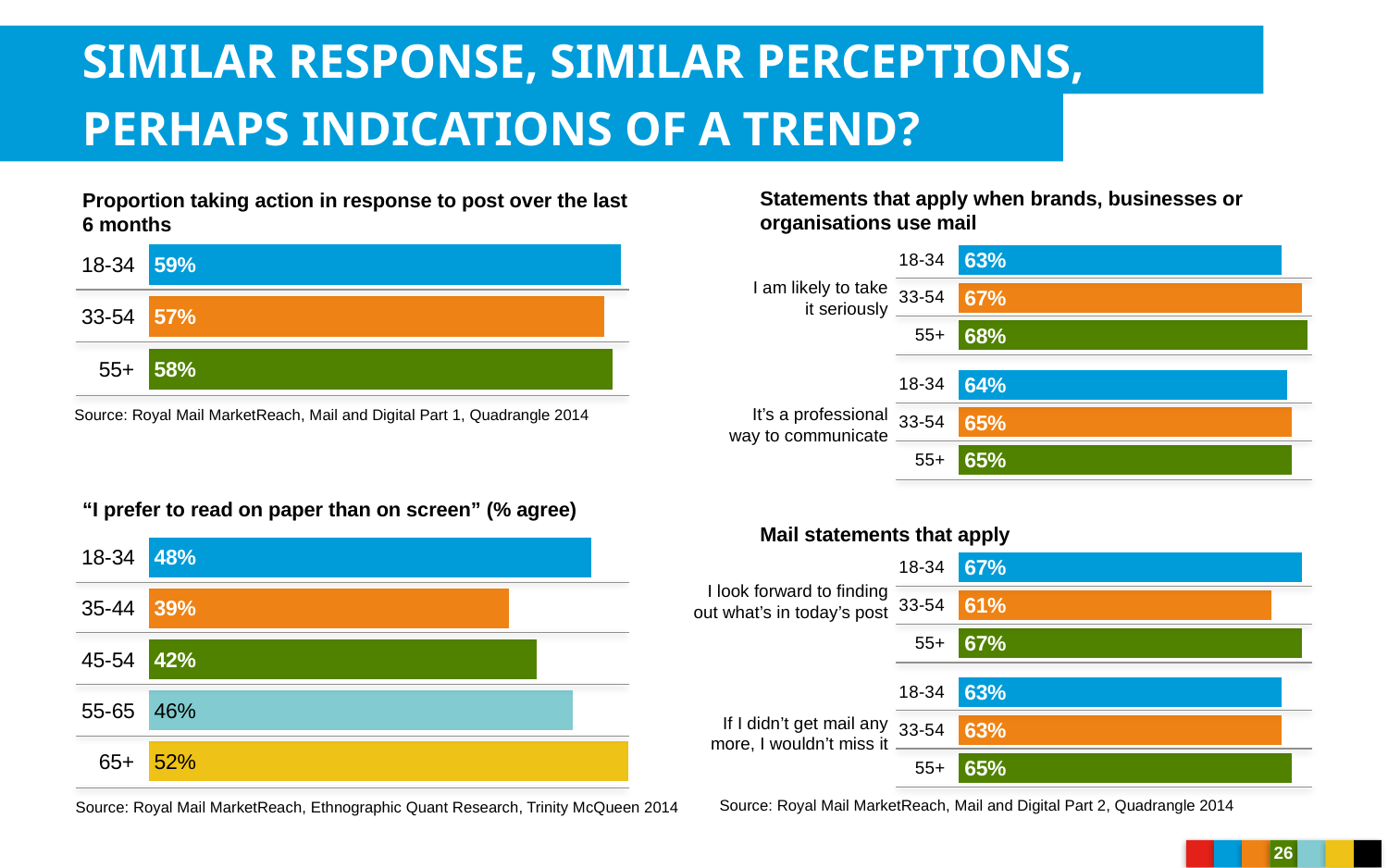
In the chart 'I prefer to read on paper than on screen', which age group has the highest value? 65+ In the chart 'Proportion taking action in response to post over the last 6 months', which age group has the lowest value? 33-54 In the chart 'I prefer to read on paper than on screen', what is the difference between the 65+ and 35-44 values? 13% In the chart 'Statements that apply when brands, businesses or organisations use mail', which age group has the lowest value for 'I am likely to take it seriously'? 18-34 In the chart 'Mail statements that apply', which is larger for 'If I didn't get mail any more, I wouldn't miss it': the 18-34 value or the 55+ value? 55+ What type of chart is 'Proportion taking action in response to post over the last 6 months'? Bar chart In the chart 'Mail statements that apply', what is the difference between the 18-34 and 33-54 values for 'I look forward to finding out what's in today's post'? 6% In the chart 'Statements that apply when brands, businesses or organisations use mail', what is the 55+ value for 'I am likely to take it seriously'? 68% In the chart 'Proportion taking action in response to post over the last 6 months', what is the value for the 18-34 group? 59% In the chart 'Mail statements that apply', what is the 33-54 value for 'I look forward to finding out what's in today's post'? 61% How many age groups are shown in the chart 'I prefer to read on paper than on screen'? 5 In the chart 'I prefer to read on paper than on screen', what is the value for the 35-44 group? 39%